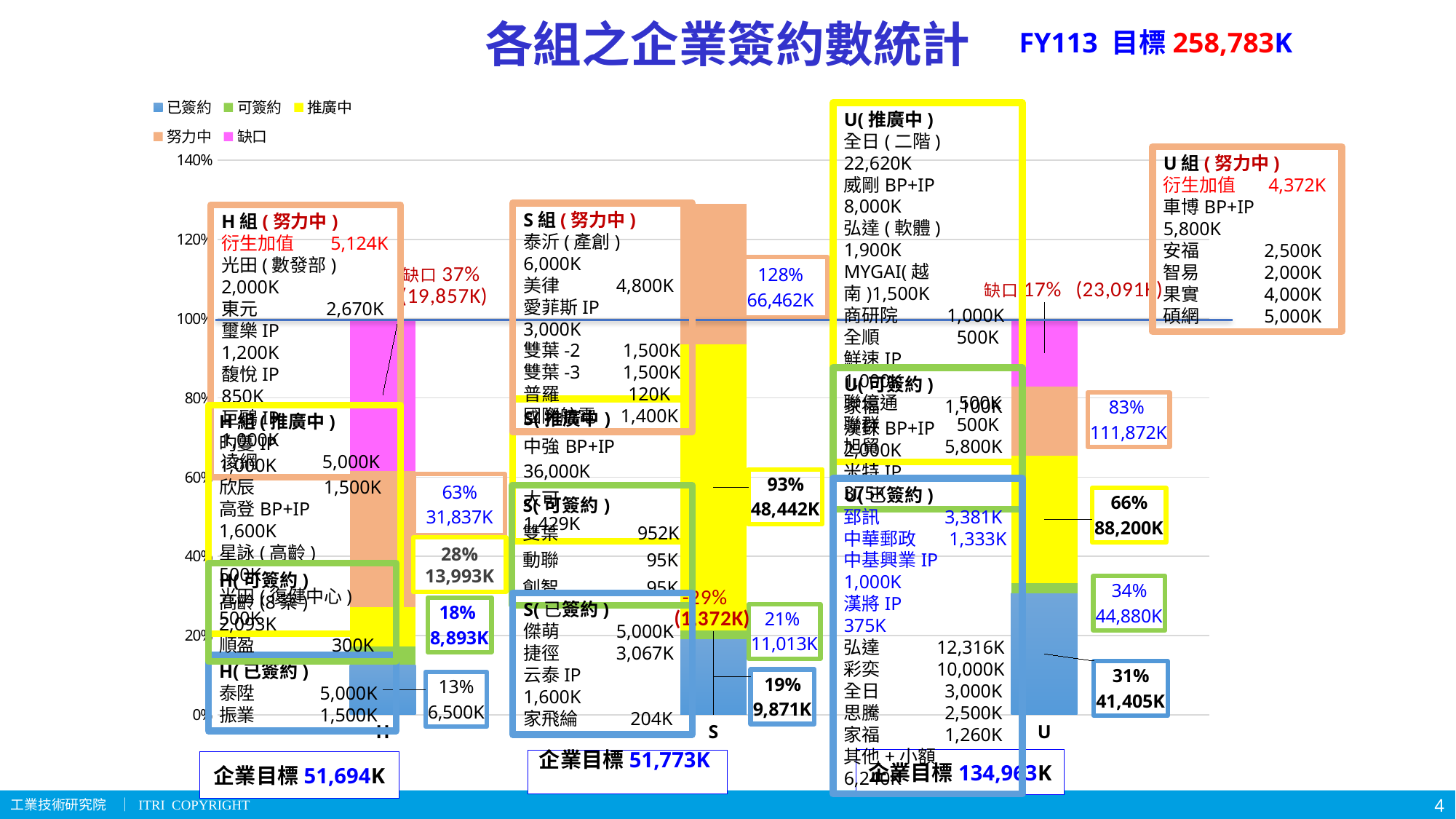
What is the difference between the 已簽約 values of group U and group H? 34,905K Which group has the highest 已簽約 value? U How many groups (categories) are plotted along the x axis? 3 Which group has the larger 已簽約 value, H or S? S How many series does the chart legend list? 5 What is the 已簽約 value labelled for group U? 41,405K What is the 缺口 labelled for group U? 17% (23,091K) What is the title of the chart? 各組之企業簽約數統計 What kind of chart is shown on the slide? bar chart What percentage is labelled for the 努力中 level of group S? 128% What is the 已簽約 value labelled for group H? 6,500K What is the 企業目標 shown for group U? 134,963K